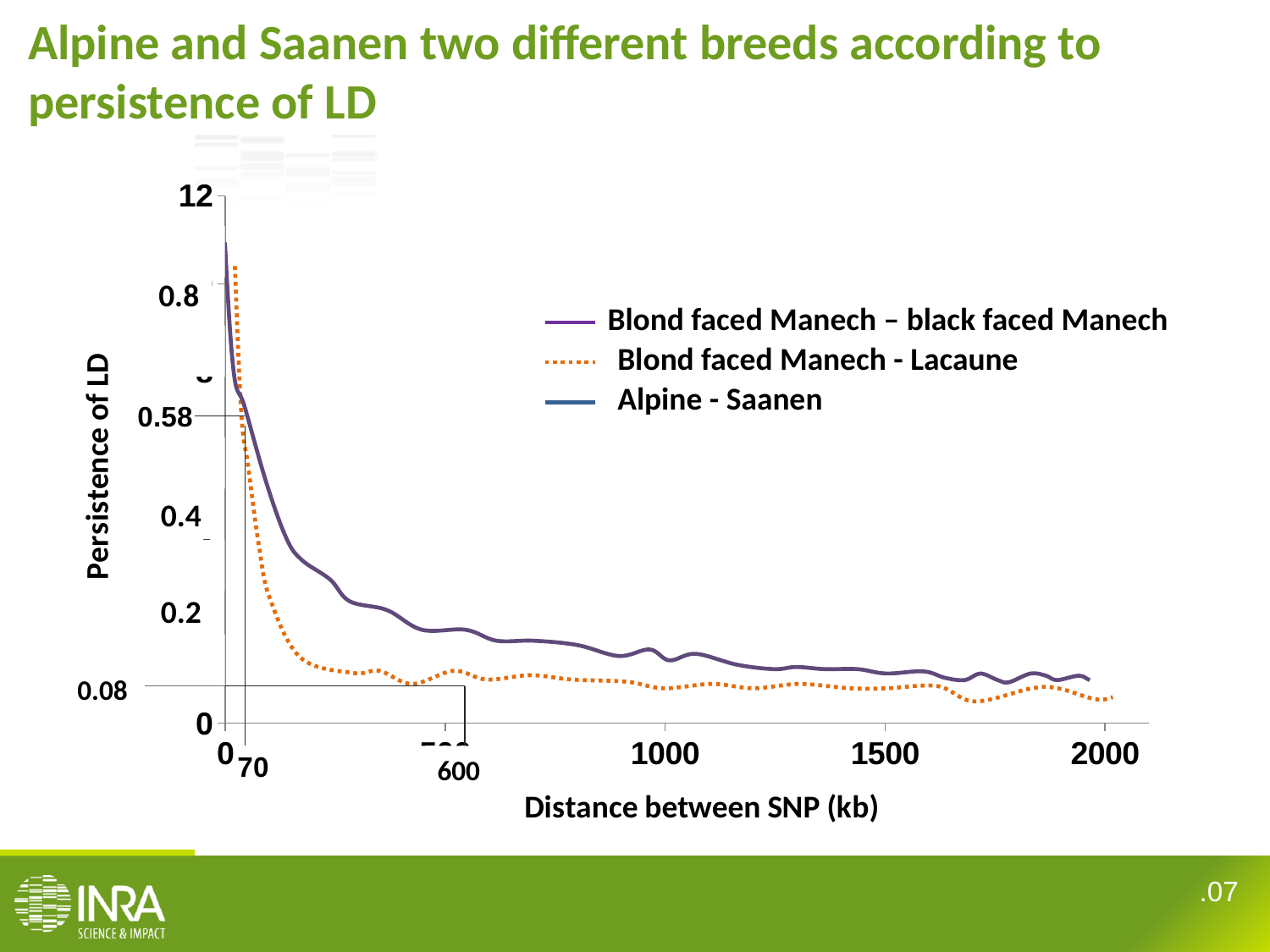
What kind of chart is shown on the slide? line chart Do the plotted values rise or fall as the distance between SNP increases? fall Which series is drawn with a dotted line? Blond faced Manech - Lacaune At 1000 kb, which series has the higher persistence of LD: Blond faced Manech – black faced Manech or Blond faced Manech - Lacaune? Blond faced Manech – black faced Manech Is the value for Blond faced Manech – black faced Manech at 1000 kb greater or less than 0.2? less What is the title of the y axis? Persistence of LD What persistence of LD value is annotated at a distance of 70 kb? 0.58 Is the value for Blond faced Manech – black faced Manech at 500 kb greater or less than 0.4? less What persistence of LD value is annotated at a distance of 600 kb? 0.08 How many series does the legend list? 3 What is the title of the x axis? Distance between SNP (kb) Is the value for Blond faced Manech - Lacaune at 1500 kb greater or less than 0.2? less